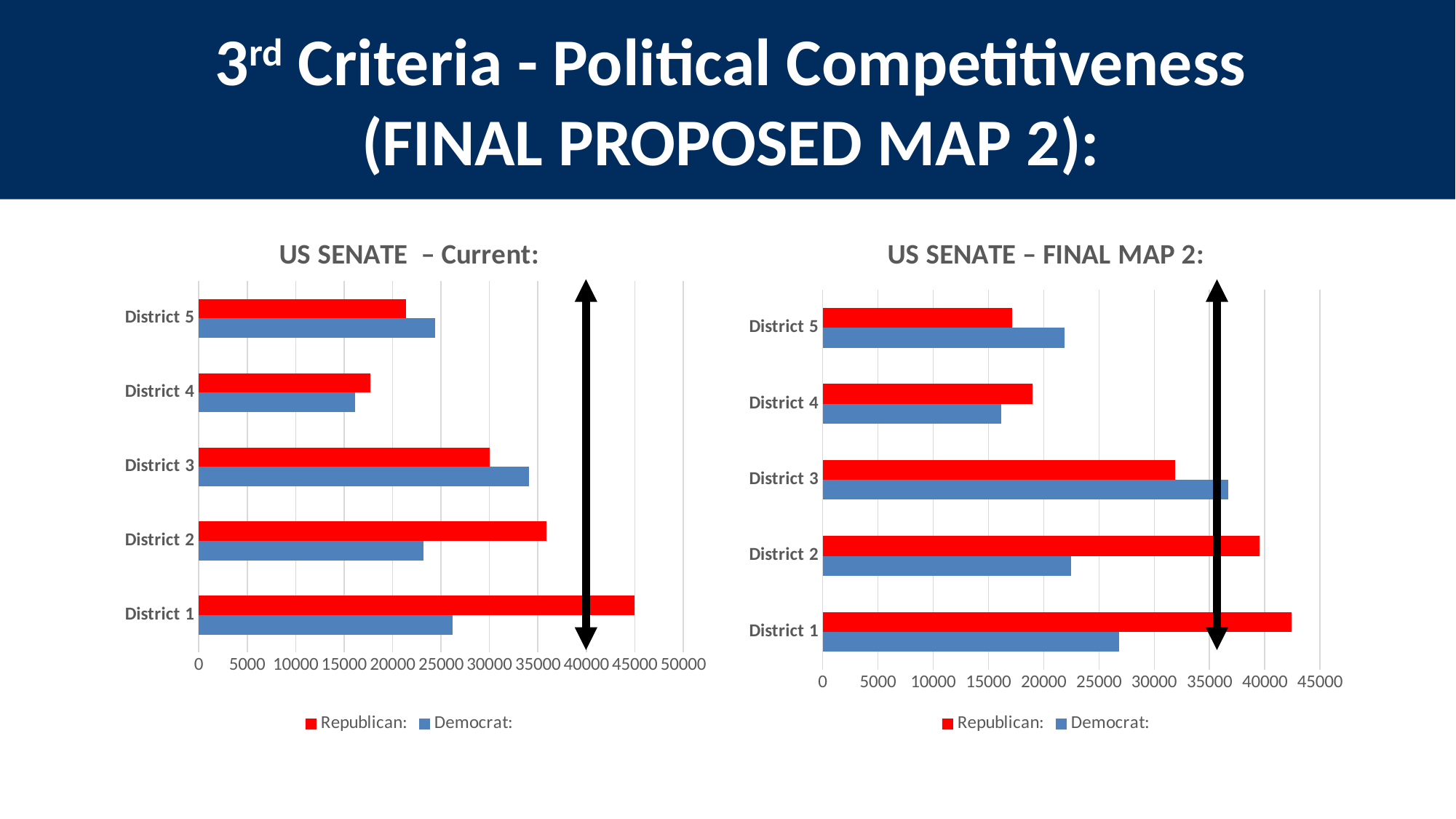
In the "US SENATE – FINAL MAP 2:" chart, which district has the lowest Democrat value? District 4 How many series does the legend of the "US SENATE – FINAL MAP 2:" chart list? 2 In the "US SENATE – Current:" chart, which district has the highest Republican value? District 1 In the "US SENATE – Current:" chart, is the Republican value for District 2 greater or less than 30000? greater What kind of chart is the "US SENATE – Current:" chart? bar chart In the "US SENATE – FINAL MAP 2:" chart, which district has the highest Democrat value? District 3 In the "US SENATE – FINAL MAP 2:" chart, which is larger for District 4, the Republican or the Democrat value? Republican What colour represents the Republican series in the charts? red In the "US SENATE – FINAL MAP 2:" chart, is the Democrat value for District 5 greater or less than 25000? less How many districts are shown on the "US SENATE – Current:" chart? 5 In the "US SENATE – Current:" chart, which is larger for District 3, the Republican or the Democrat value? Democrat In the "US SENATE – FINAL MAP 2:" chart, is the Republican value for District 1 greater or less than 40000? greater